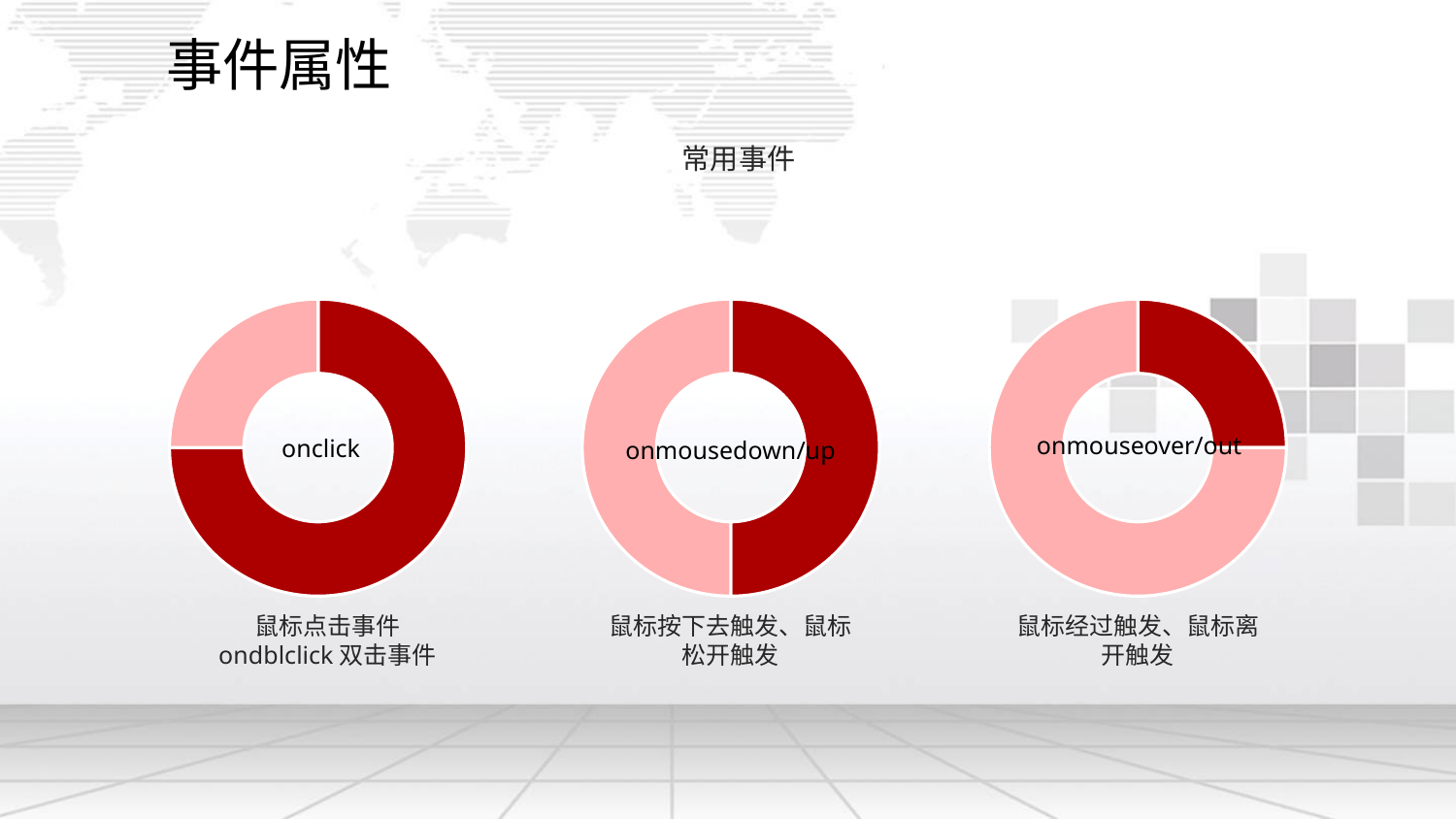
What text is shown in the centre of the middle doughnut chart on the slide? onmousedown/up In the chart labelled "onmouseover/out" on the right of the slide, which slice is larger, the dark red one or the light pink one? The light pink one What text is shown in the centre of the right-hand doughnut chart on the slide? onmouseover/out How many slices does the chart labelled "onclick" on the left of the slide have? 2 How many slices does the chart labelled "onmousedown/up" in the middle of the slide have? 2 How many slices does the chart labelled "onmouseover/out" on the right of the slide have? 2 What kind of chart is the chart labelled "onclick" on the left of the slide? Doughnut (pie) chart In the chart labelled "onclick" on the left of the slide, which slice is larger, the dark red one or the light pink one? The dark red one